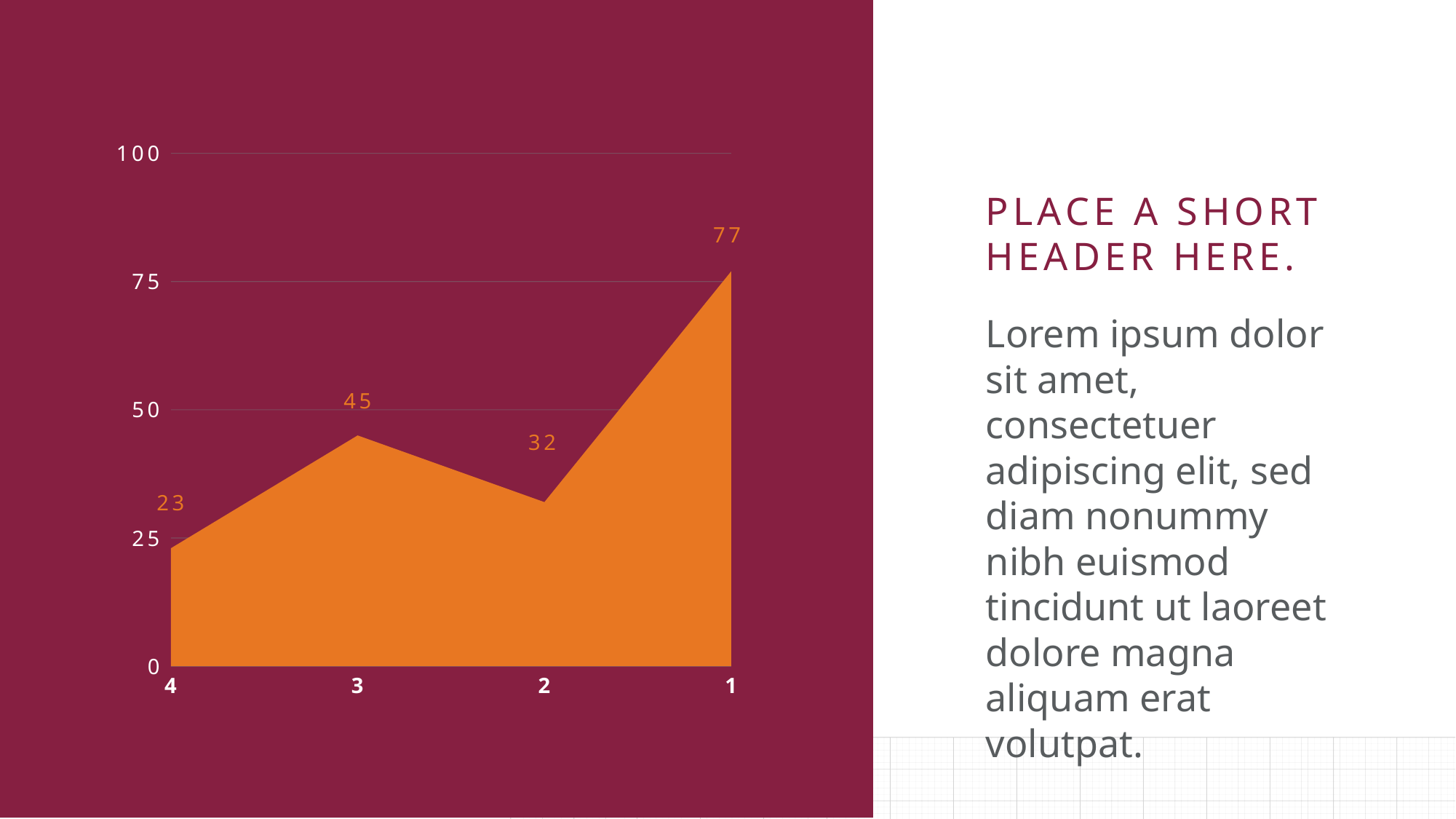
What is the value for category 2? 32 Which category has the lowest value? 4 Is the value for category 1 greater or less than 75? greater What is the value for category 3? 45 What is the value for category 4? 23 What kind of chart is shown on the slide? area chart Which category has the highest value? 1 What is the value for category 1? 77 What is the difference between the values for category 3 and category 2? 13 What is the difference between the values for category 1 and category 3? 32 Which is larger, the value for category 2 or the value for category 4? category 2 How many categories are plotted on the x axis? 4